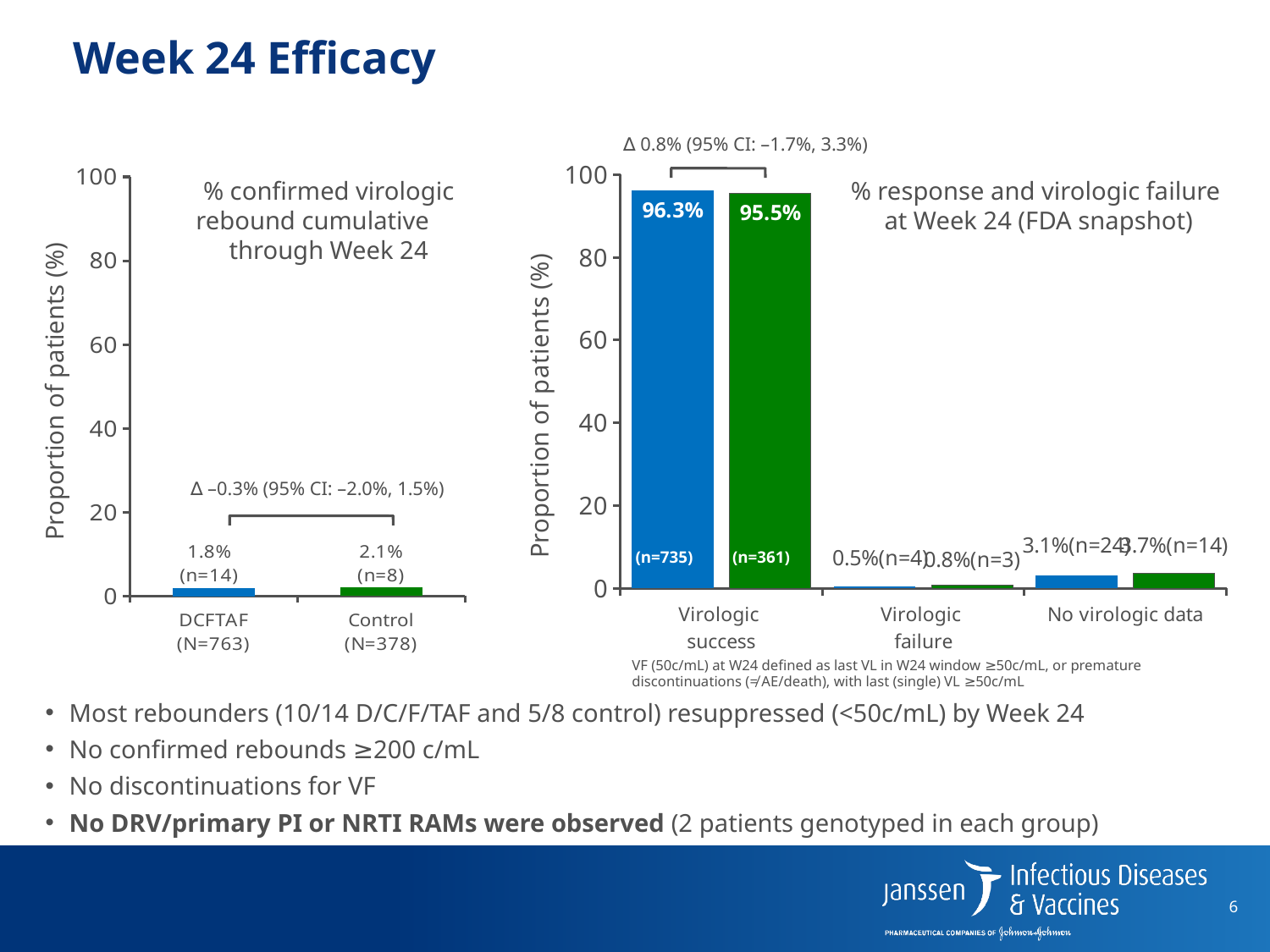
In the right chart (% response and virologic failure at Week 24), what is the value of the blue bar for Virologic failure? 0.5% In the right chart (% response and virologic failure at Week 24), what is the difference between the blue and green bars for Virologic success? 0.8% In the left chart (% confirmed virologic rebound cumulative through Week 24), how many categories are shown on the x axis? 2 In the right chart (% response and virologic failure at Week 24), what is the value of the blue bar for Virologic success? 96.3% What kind of chart is the right chart (% response and virologic failure at Week 24)? Bar chart In the left chart (% confirmed virologic rebound cumulative through Week 24), how many patients (n) had confirmed rebound in the DCFTAF group? n=14 In the left chart (% confirmed virologic rebound cumulative through Week 24), what is the value for Control (N=378)? 2.1% In the right chart (% response and virologic failure at Week 24), which category has the highest values? Virologic success In the right chart (% response and virologic failure at Week 24), what is the value of the green bar for No virologic data? 3.7% In the left chart (% confirmed virologic rebound cumulative through Week 24), what is the value for DCFTAF (N=763)? 1.8% In the right chart (% response and virologic failure at Week 24), what is the value of the green bar for Virologic success? 95.5% In the left chart (% confirmed virologic rebound cumulative through Week 24), what is the difference between the Control and DCFTAF values? 0.3%